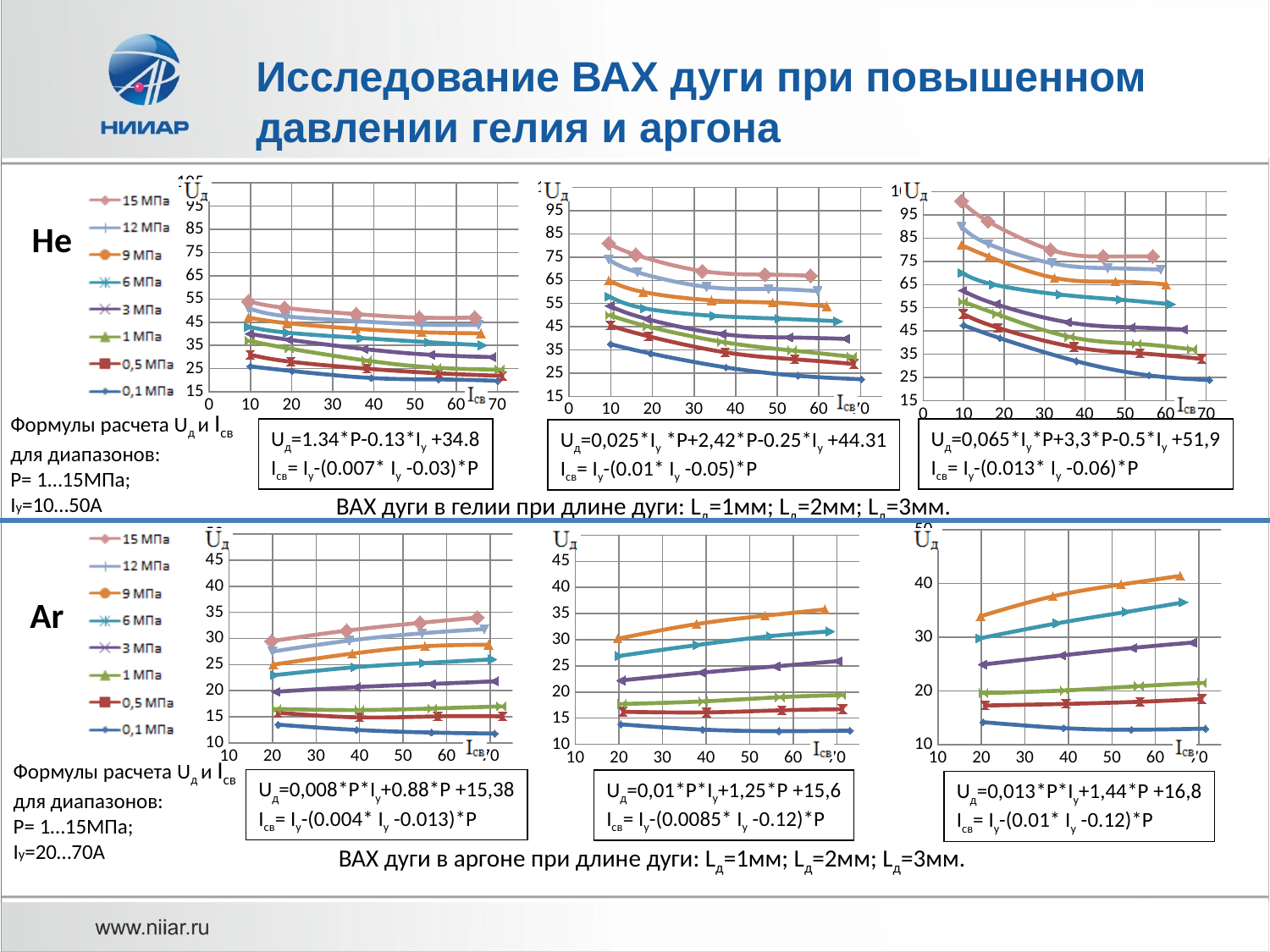
In the top-left helium chart (Lд=1мм), do the values for 15 МПа rise or fall as Iсв increases? fall In the top-middle helium chart (Lд=2мм), is the value for 0,1 МПа at Iсв=10 greater or less than 45? less In the top-left helium chart (Lд=1мм), which is larger at Iсв=10: the value for 15 МПа or the value for 0,1 МПа? 15 МПа In the top-right helium chart (Lд=3мм), which series has the highest values across the whole current range? 15 МПа In the top-right helium chart (Lд=3мм), is the value for 15 МПа at Iсв=10 greater or less than 85? greater What kind of chart is the top-left helium chart (Lд=1мм)? line chart How many series does the legend for the helium charts list? 8 In the bottom-middle argon chart (Lд=2мм), is the value for 0,1 МПа at Iсв=20 greater or less than 15? less How many series are plotted in the bottom-right argon chart (Lд=3мм)? 6 In the bottom-left argon chart (Lд=1мм), do the values for 15 МПа rise or fall as Iсв increases? rise